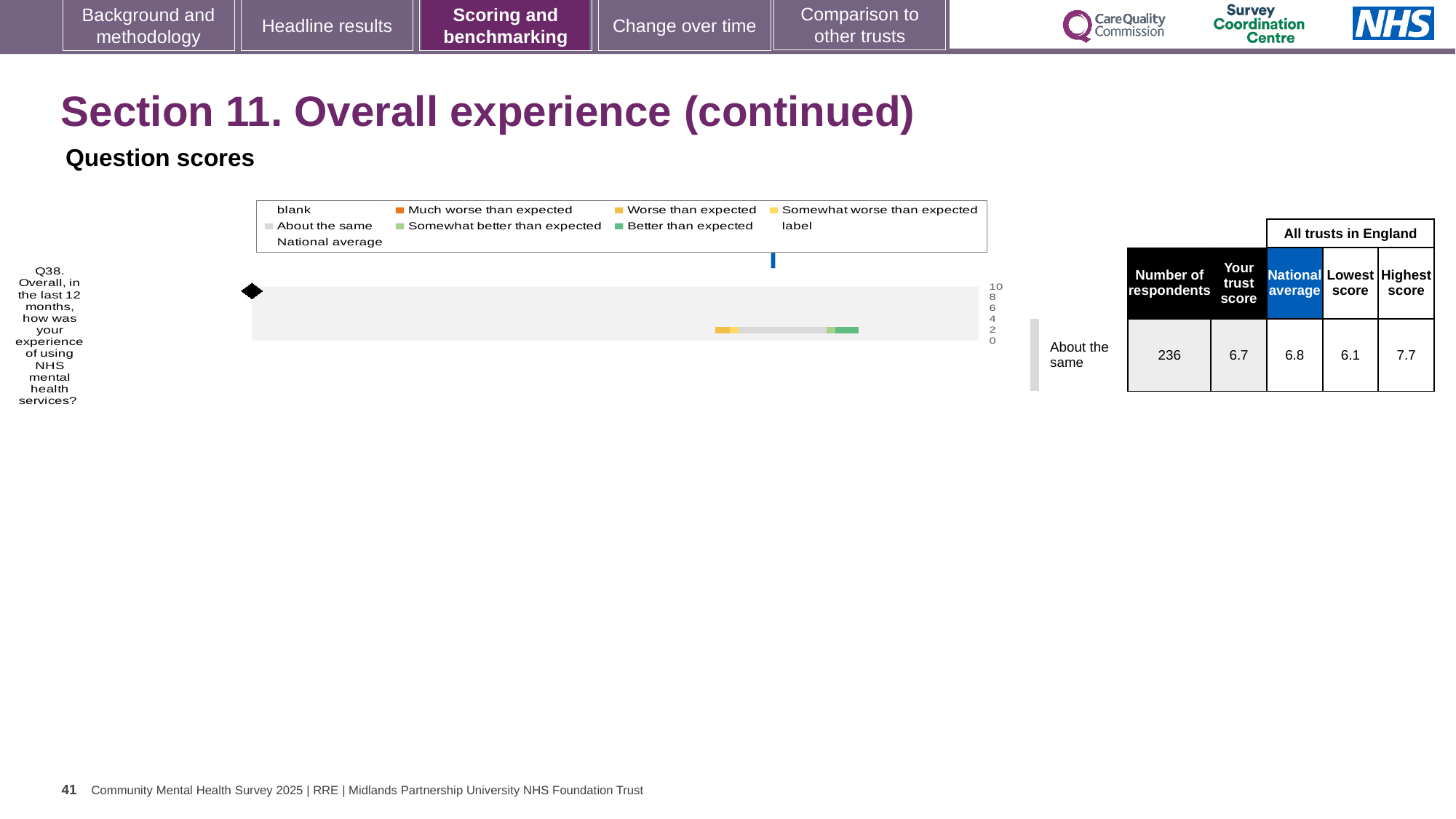
How many entries does the chart legend list? 9 What is the highest tick value shown on the chart's score axis? 10 What kind of chart is used to show the Q38 question score? bar chart In the table beside the chart, what is the number of respondents for Q38? 236 What is the difference between the highest and lowest scores among all trusts in England for Q38? 1.6 Which question number is plotted on the chart? Q38 How many survey questions are plotted on the chart? 1 In the table beside the chart, what is the highest score among all trusts in England for Q38? 7.7 In the table beside the chart, what is the lowest score among all trusts in England for Q38? 6.1 In the table beside the chart, what is the trust's score for Q38? 6.7 Which is larger for Q38: the trust's score or the national average? national average In the table beside the chart, what is the national average score for Q38? 6.8